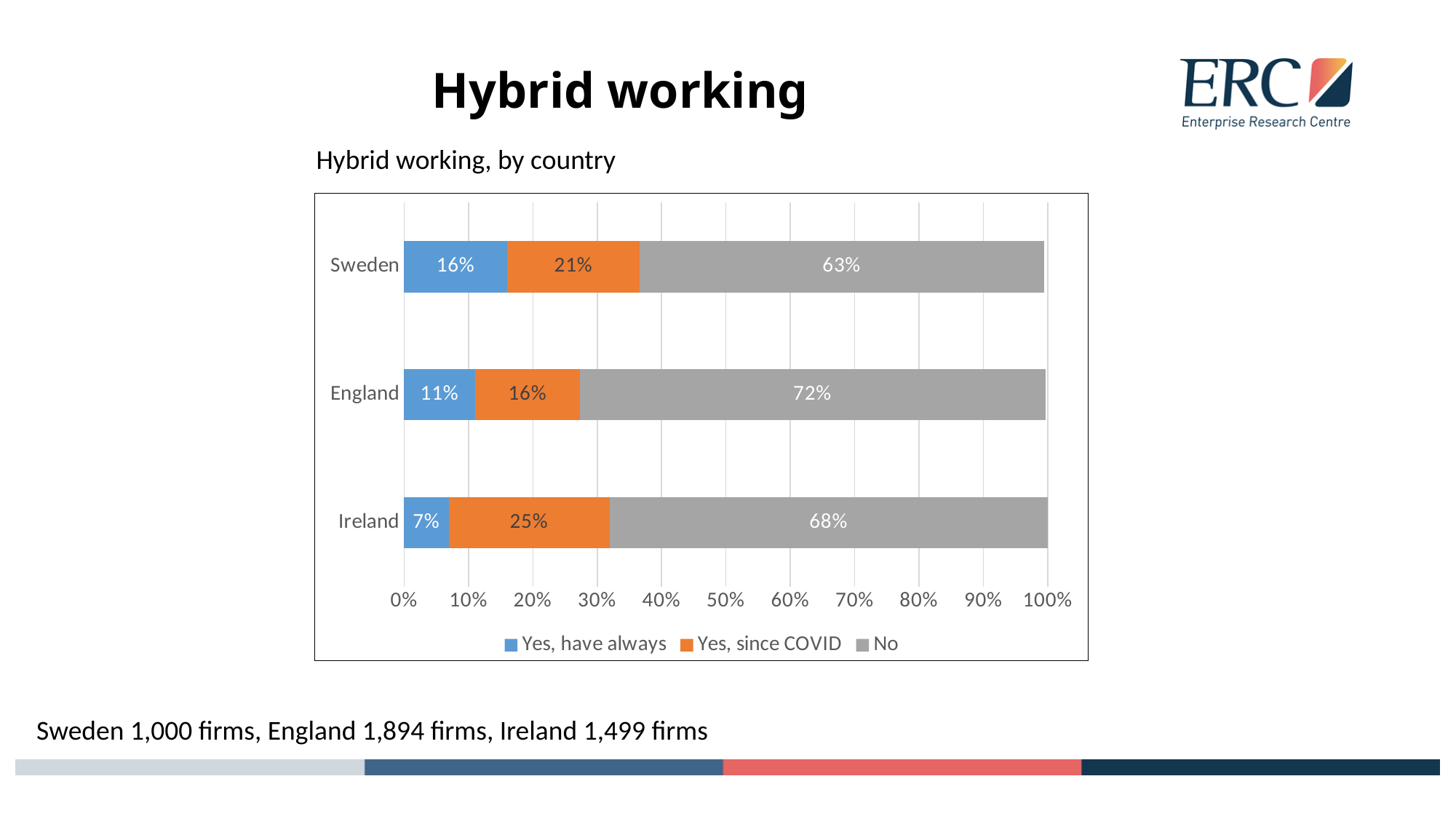
What percentage of firms in Ireland answered "Yes, since COVID"? 25% What percentage of firms in England answered "No"? 72% Is the "No" share for Sweden greater or less than 60%? greater Which country has the highest share of firms answering "No"? England What percentage of firms in Sweden answered "Yes, have always"? 16% What is the title of the chart? Hybrid working, by country What kind of chart is shown on the slide? Stacked bar chart Which is larger: the "Yes, have always" share for Sweden or for England? Sweden Which country has the lowest share of firms answering "Yes, have always"? Ireland What is the difference between the "Yes, since COVID" shares for Ireland and England? 9 percentage points How many series does the legend list? 3 How many countries are shown in the chart? 3